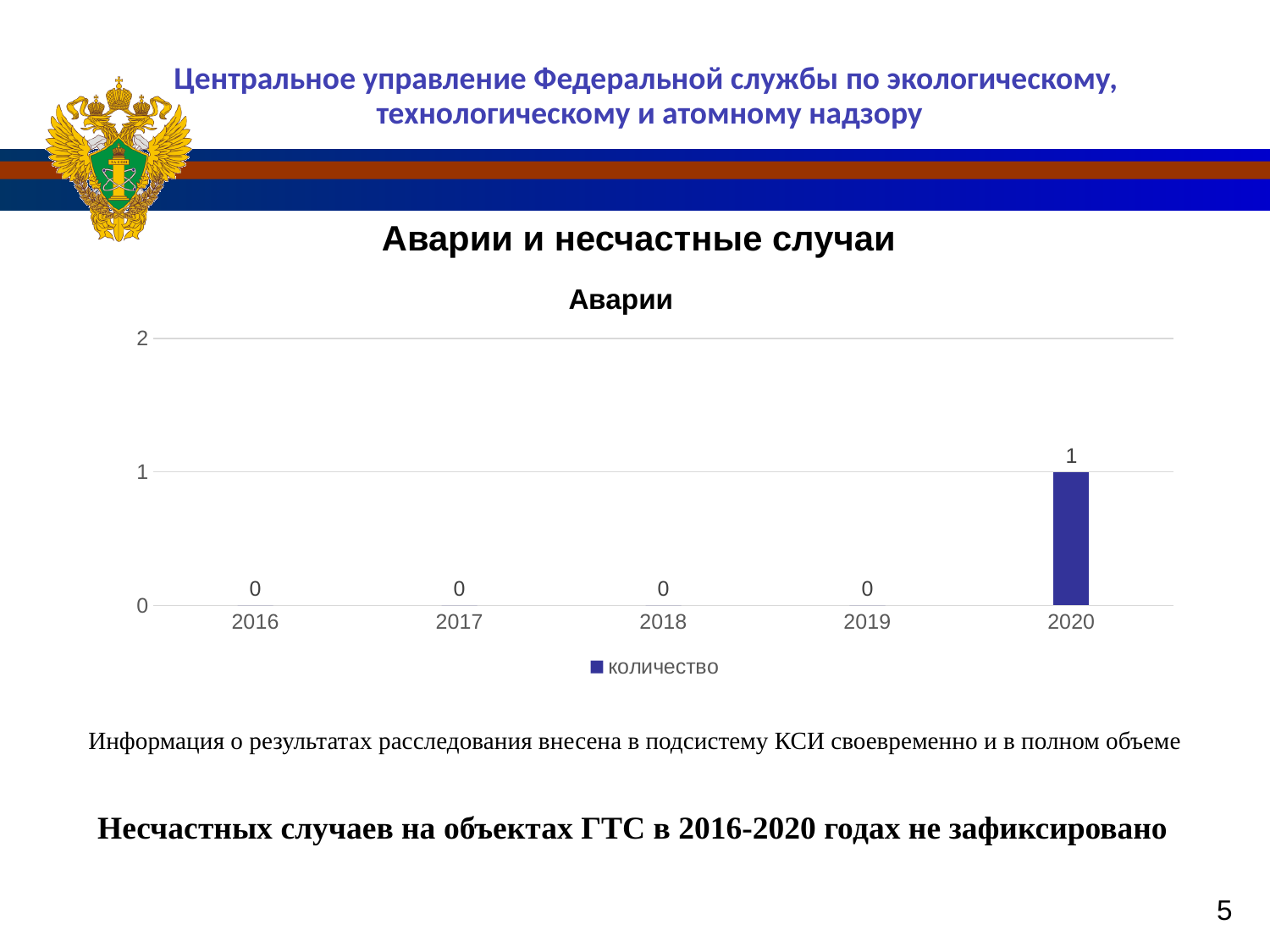
What is the name of the series in the legend? количество What is the difference between the values for 2020 and 2019? 1 What is the title of the chart? Аварии Is the value for 2020 greater or less than 2? less What is the value for 2020 in the chart? 1 How many series does the legend list? 1 How many years are shown on the x axis of the chart? 5 What is the value for 2018 in the chart? 0 Which year has the highest value in the chart? 2020 What kind of chart is shown on the slide? bar chart Which is larger, the value for 2020 or the value for 2017? 2020 What is the value for 2016 in the chart? 0